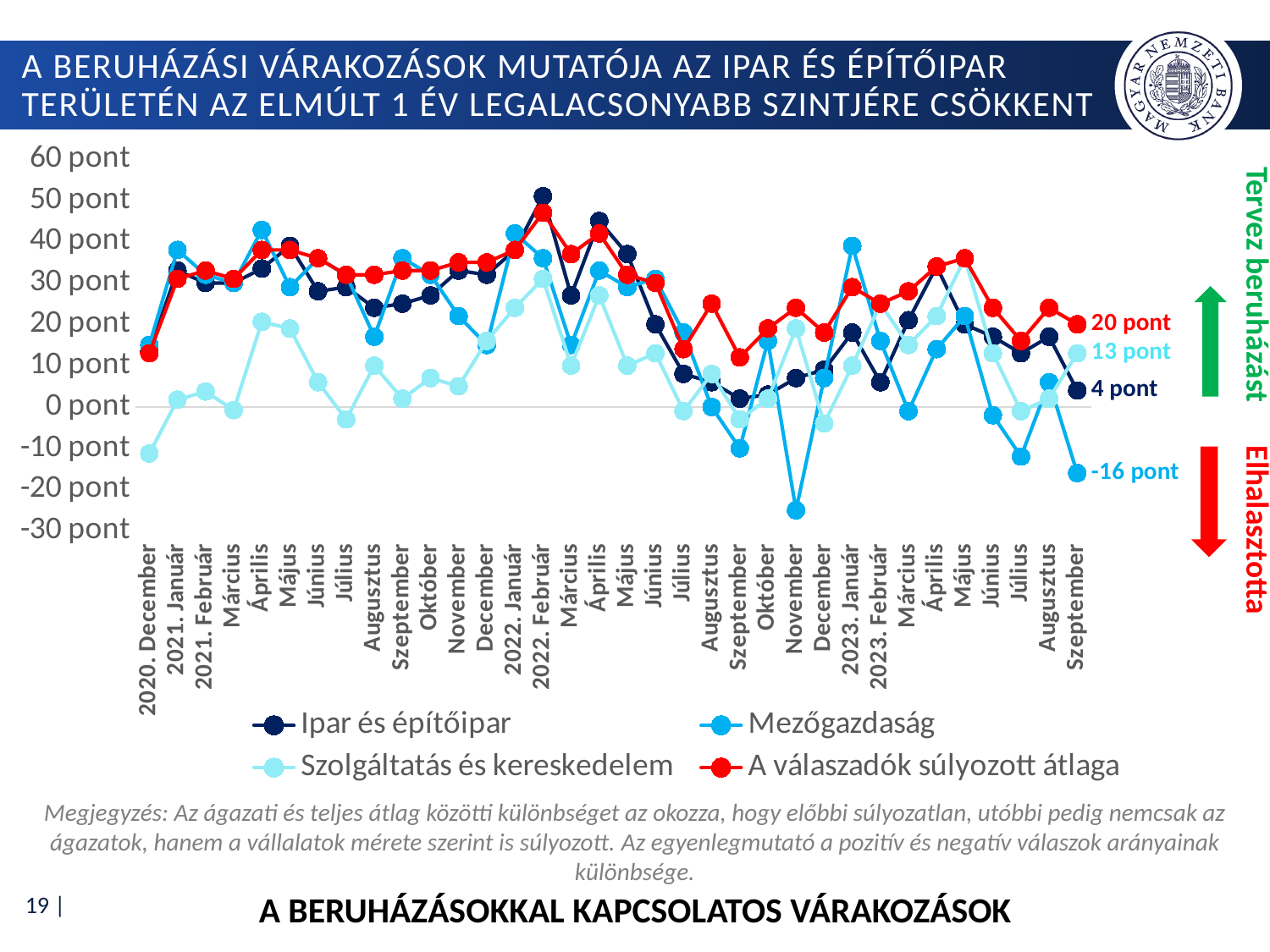
Which series has the lowest value in 2023 Szeptember? Mezőgazdaság What is the value of "Ipar és építőipar" in 2023 Szeptember? 4 pont What kind of chart is shown on the slide? line chart What is the value of "Szolgáltatás és kereskedelem" in 2023 Szeptember? 13 pont What is the difference between "A válaszadók súlyozott átlaga" and "Ipar és építőipar" in 2023 Szeptember? 16 pont In 2023 Szeptember, which is larger: "Szolgáltatás és kereskedelem" or "Ipar és építőipar"? Szolgáltatás és kereskedelem Does the "Mezőgazdaság" series rise or fall from 2023 Május to 2023 Szeptember? fall What is the value of "A válaszadók súlyozott átlaga" in 2023 Szeptember? 20 pont Which series has the highest value in 2023 Szeptember? A válaszadók súlyozott átlaga How many series does the legend list? 4 What is the value of "Mezőgazdaság" in 2023 Szeptember? -16 pont Is the value for "Mezőgazdaság" in 2022 November greater or less than -20 pont? less